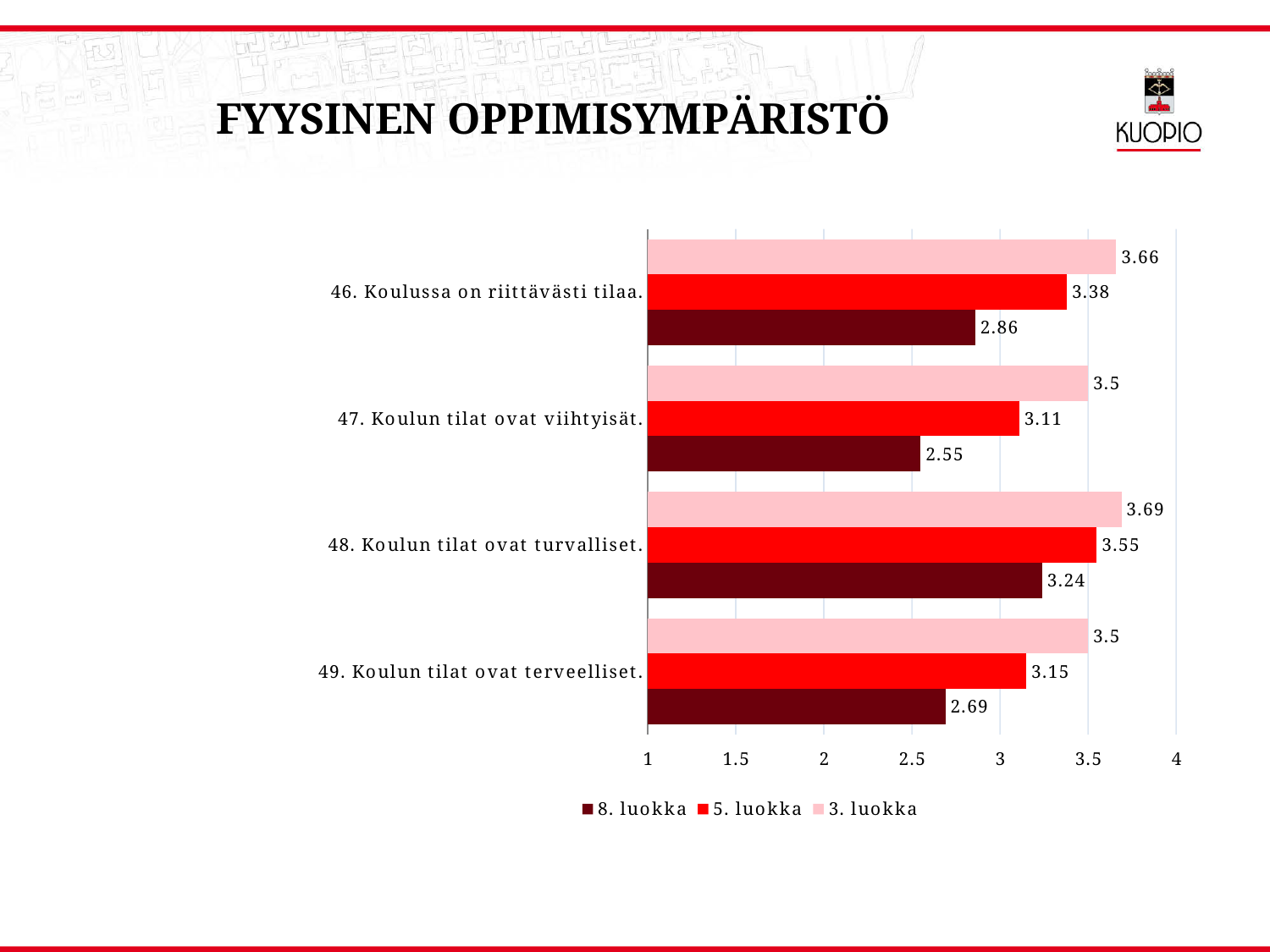
What is the value for 8. luokka on "47. Koulun tilat ovat viihtyisät."? 2.55 What is the difference between the 3. luokka and 8. luokka values for "47. Koulun tilat ovat viihtyisät."? 0.95 Which category has the highest value for 8. luokka? 48. Koulun tilat ovat turvalliset. How many categories are shown on the chart? 4 What is the title of the slide? FYYSINEN OPPIMISYMPÄRISTÖ Which category has the lowest value for 5. luokka? 47. Koulun tilat ovat viihtyisät. What is the value for 5. luokka on "49. Koulun tilat ovat terveelliset."? 3.15 Which is larger: the 5. luokka value for "46. Koulussa on riittävästi tilaa." or the 5. luokka value for "48. Koulun tilat ovat turvalliset."? 48. Koulun tilat ovat turvalliset. What kind of chart is shown on the slide? bar chart Is the 8. luokka value for "49. Koulun tilat ovat terveelliset." greater or less than 3? less How many series does the legend list? 3 What is the value for 3. luokka on "46. Koulussa on riittävästi tilaa."? 3.66